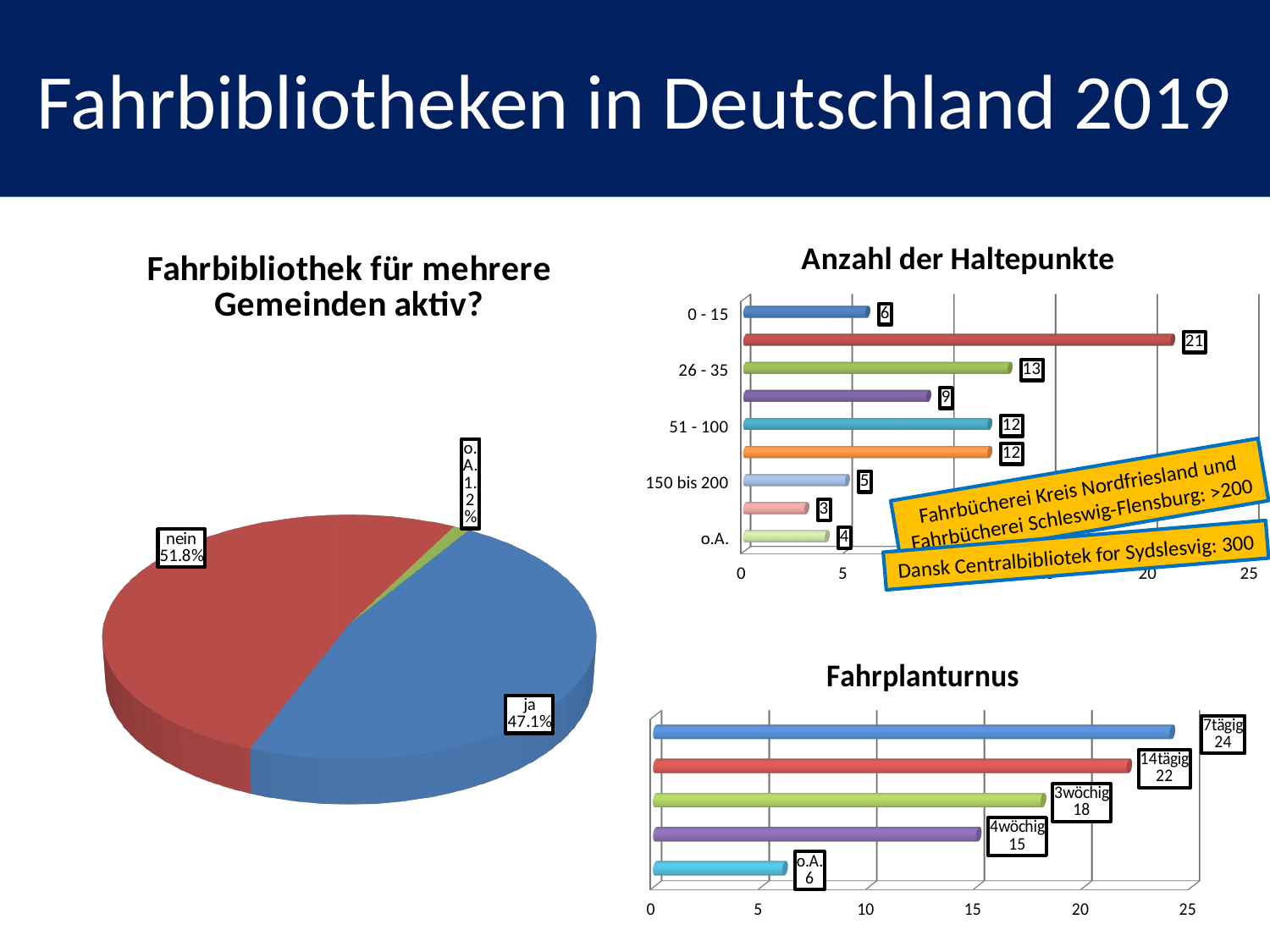
In the chart 'Fahrplanturnus', what is the difference between the values for '7tägig' and '4wöchig'? 9 In the chart 'Fahrplanturnus', which category has the highest value? 7tägig In the chart 'Anzahl der Haltepunkte', what is the value for '0 - 15'? 6 In the pie chart 'Fahrbibliothek für mehrere Gemeinden aktiv?', which slice is the smallest? o.A. What kind of chart is 'Fahrplanturnus'? bar chart In the pie chart 'Fahrbibliothek für mehrere Gemeinden aktiv?', how many slices are there? 3 In the chart 'Anzahl der Haltepunkte', what is the value for '26 - 35'? 13 In the pie chart 'Fahrbibliothek für mehrere Gemeinden aktiv?', what share is labelled 'nein'? 51.8% In the chart 'Anzahl der Haltepunkte', what is the value for '150 bis 200'? 5 In the chart 'Fahrplanturnus', what is the value for '3wöchig'? 18 In the chart 'Anzahl der Haltepunkte', what is the difference between the values for '26 - 35' and '51 - 100'? 1 In the pie chart 'Fahrbibliothek für mehrere Gemeinden aktiv?', what share is labelled 'ja'? 47.1%